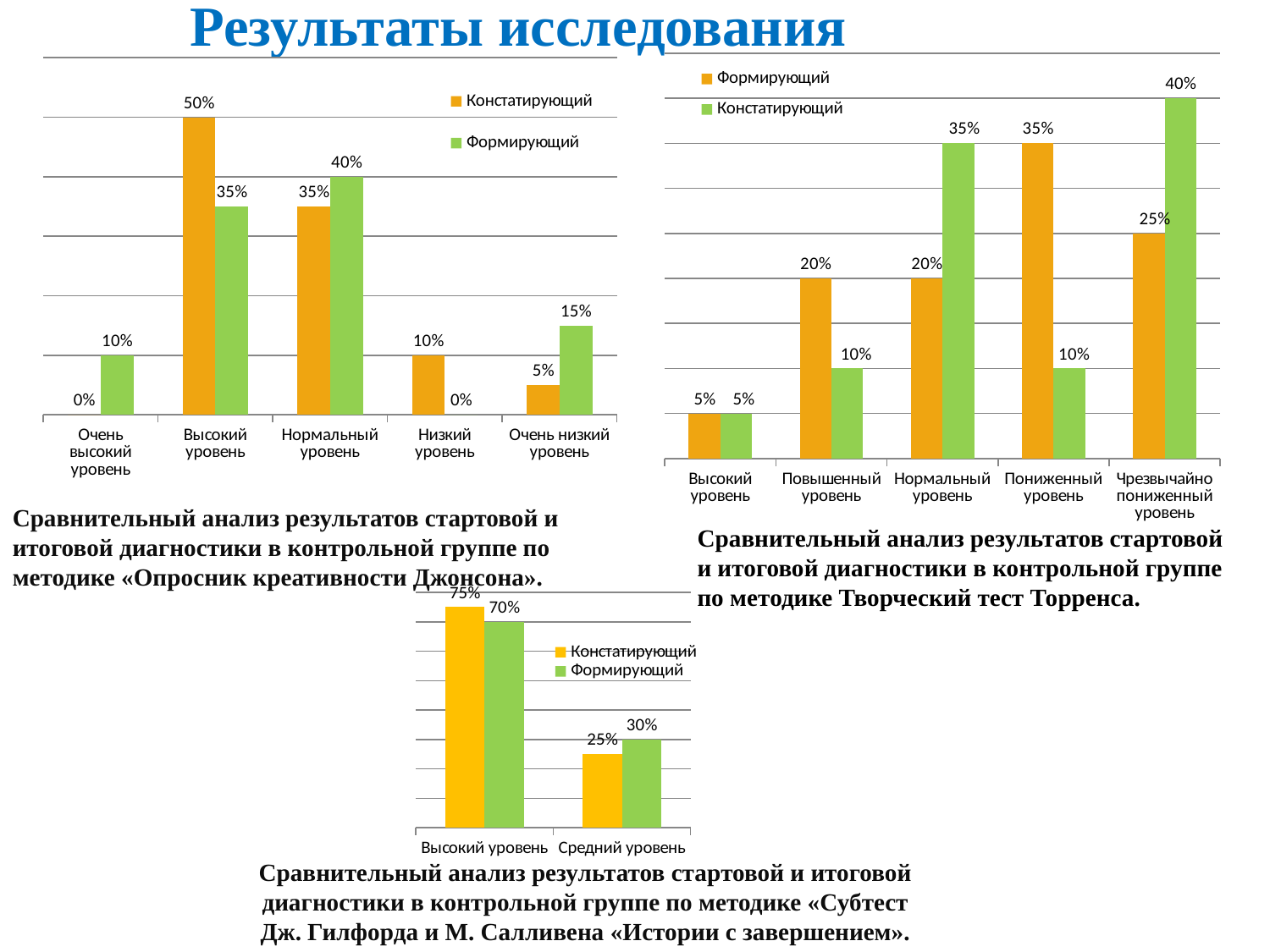
In the bottom chart, what is the value for Формирующий at Средний уровень? 30% How many series does the legend of the bottom chart list? 2 In the top-left chart, which category has the highest Констатирующий value? Высокий уровень In the top-right chart, what is the difference between Констатирующий and Формирующий at Чрезвычайно пониженный уровень? 15% In the top-left chart, how many categories are shown on the x axis? 5 In the top-right chart, which is larger at Пониженный уровень: Формирующий or Констатирующий? Формирующий In the top-left chart, what is the value for Формирующий at Очень низкий уровень? 15% In the bottom chart, what is the difference between Констатирующий and Формирующий at Высокий уровень? 5% In the top-right chart, what is the value for Констатирующий at Нормальный уровень? 35% In the top-left chart, what is the value for Констатирующий at Высокий уровень? 50% In the top-left chart, what is the difference between the Констатирующий and Формирующий values at Высокий уровень? 15% In the top-right chart, which category has the highest Констатирующий value? Чрезвычайно пониженный уровень